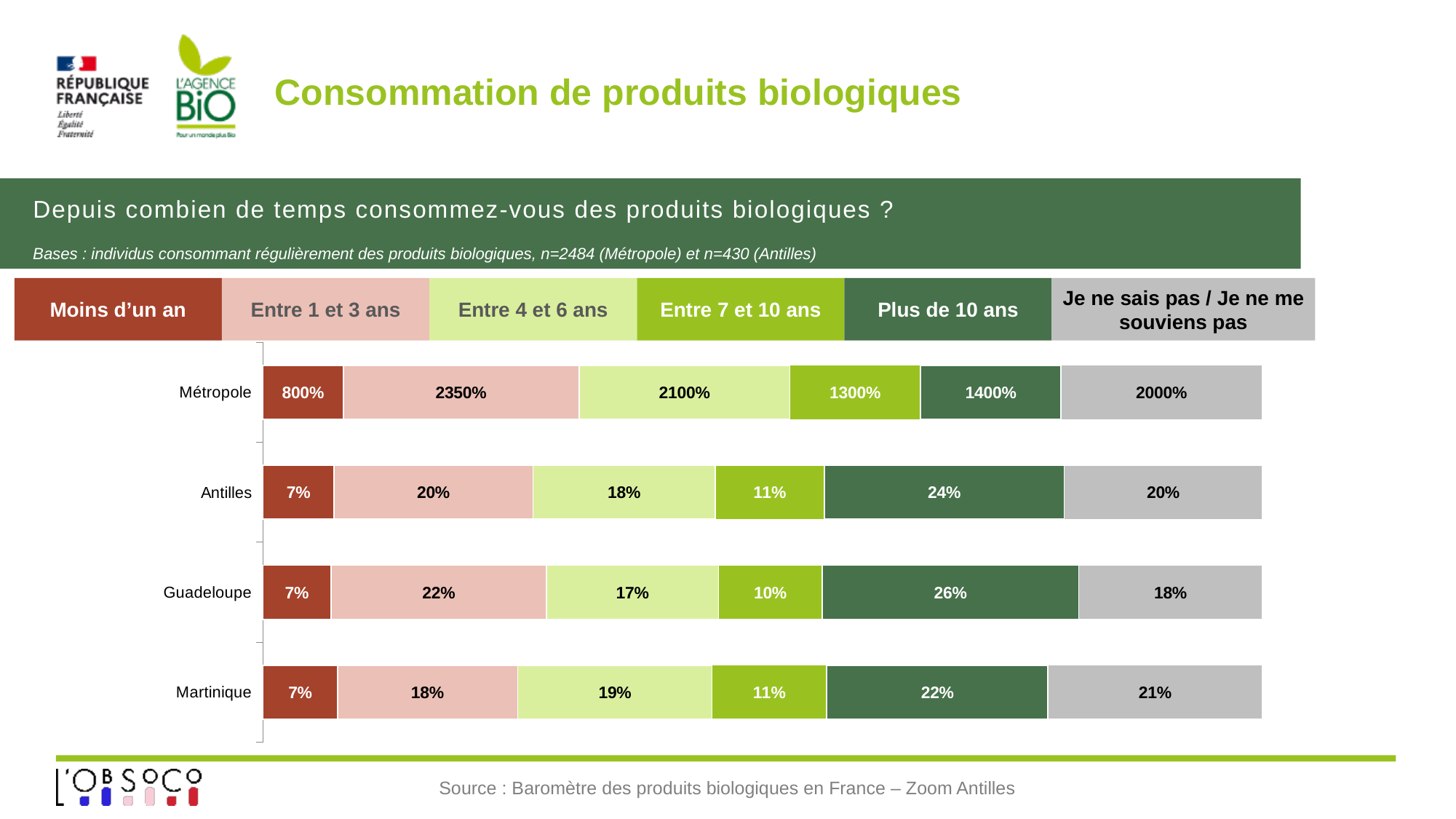
What is the value for "Moins d'un an" in the Métropole bar? 800% How many rows (categories) are shown in the chart? 4 What is the value for "Entre 1 et 3 ans" in the Antilles bar? 20% Which segment is the smallest in the Guadeloupe bar? Moins d'un an Which segment is the largest in the Antilles bar? Plus de 10 ans What is the difference between the "Plus de 10 ans" values for Guadeloupe and Martinique? 4% What colour is the "Moins d'un an" segment in the legend? Dark red What is the value for "Je ne sais pas / Je ne me souviens pas" in the Martinique bar? 21% Which is larger: "Entre 4 et 6 ans" for Martinique or "Entre 4 et 6 ans" for Guadeloupe? Martinique What is the value for "Plus de 10 ans" in the Guadeloupe bar? 26% What kind of chart is shown on the slide? Stacked bar chart How many series does the legend list? 6